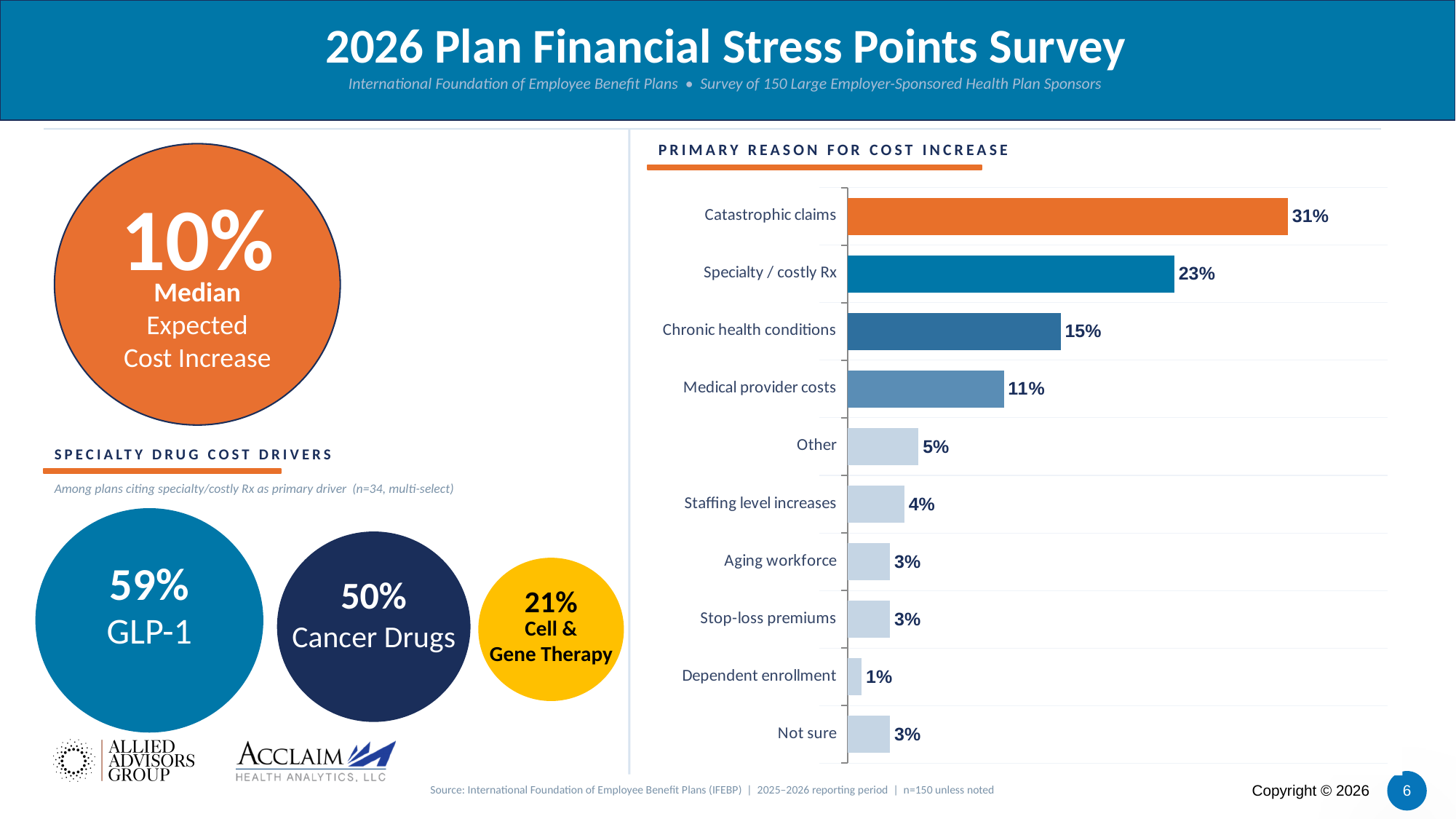
How many categories are shown in the 'Primary Reason for Cost Increase' chart? 10 In the 'Primary Reason for Cost Increase' chart, which category has the lowest value? Dependent enrollment In the 'Primary Reason for Cost Increase' chart, what is the difference between Chronic health conditions and Medical provider costs? 4% In the 'Primary Reason for Cost Increase' chart, what colour is the Catastrophic claims bar? Orange In the 'Primary Reason for Cost Increase' chart, what is the difference between Catastrophic claims and Specialty / costly Rx? 8% In the 'Primary Reason for Cost Increase' chart, what is the value for Catastrophic claims? 31% What kind of chart is the 'Primary Reason for Cost Increase' chart? Bar chart In the 'Primary Reason for Cost Increase' chart, which category has the highest value? Catastrophic claims In the 'Primary Reason for Cost Increase' chart, what is the value for Medical provider costs? 11% In the 'Primary Reason for Cost Increase' chart, what is the value for Specialty / costly Rx? 23% In the 'Primary Reason for Cost Increase' chart, which is larger: Other or Staffing level increases? Other In the 'Primary Reason for Cost Increase' chart, what is the value for Dependent enrollment? 1%